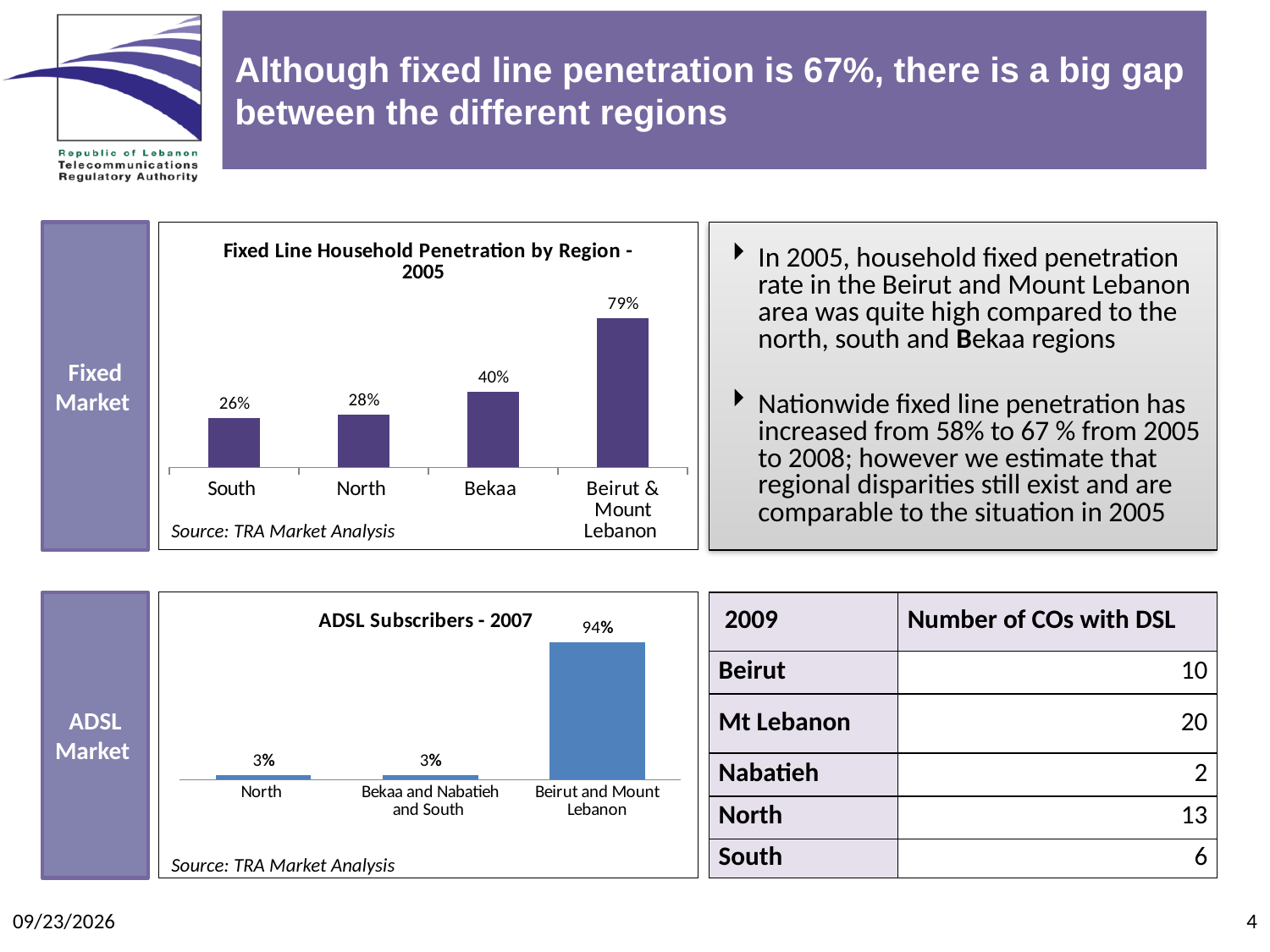
In the 'Fixed Line Household Penetration by Region - 2005' chart, what is the value for Bekaa? 40% In the 'Fixed Line Household Penetration by Region - 2005' chart, what is the difference between Beirut & Mount Lebanon and Bekaa? 39% In the 'Fixed Line Household Penetration by Region - 2005' chart, which is larger, the value for North or the value for South? North In the 'Fixed Line Household Penetration by Region - 2005' chart, which region has the lowest penetration? South In the 'Fixed Line Household Penetration by Region - 2005' chart, do the values rise or fall from left to right? rise In the 'Fixed Line Household Penetration by Region - 2005' chart, how many regions are shown? 4 In the 'ADSL Subscribers - 2007' chart, what is the value for North? 3% In the 'ADSL Subscribers - 2007' chart, what is the value for Beirut and Mount Lebanon? 94% In the 'Fixed Line Household Penetration by Region - 2005' chart, which region has the highest penetration? Beirut & Mount Lebanon What kind of chart is the 'ADSL Subscribers - 2007' chart? bar chart In the 'ADSL Subscribers - 2007' chart, what is the difference between Beirut and Mount Lebanon and Bekaa and Nabatieh and South? 91% What source is cited below the 'Fixed Line Household Penetration by Region - 2005' chart? TRA Market Analysis